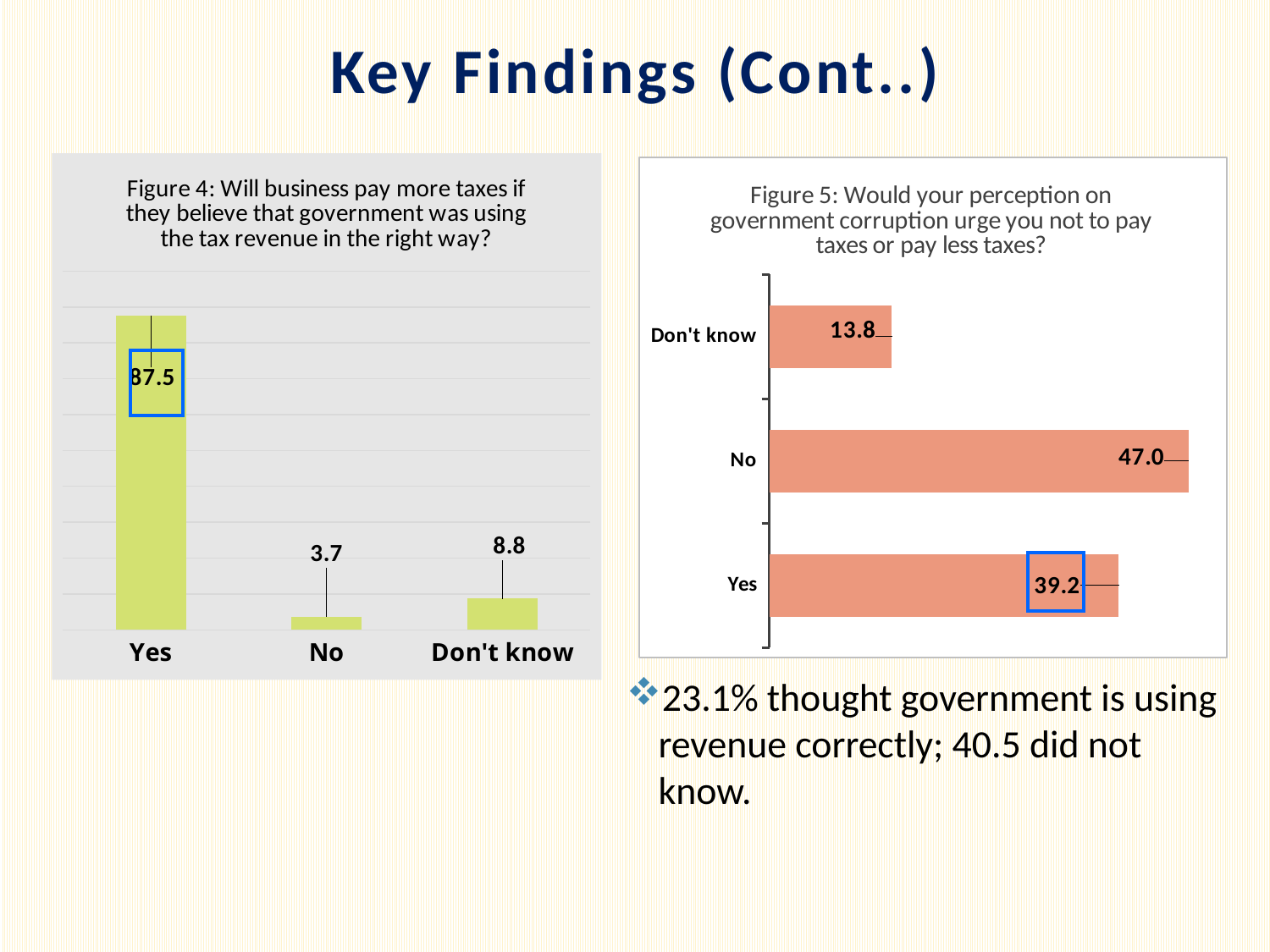
What kind of chart is Figure 5? Bar chart In Figure 5, what is the value for Don't know? 13.8 In Figure 5, what is the difference between the values for No and Yes? 7.8 In Figure 4, what is the value for Yes? 87.5 In Figure 5, what is the value for No? 47.0 In Figure 5, what is the value for Yes? 39.2 In Figure 4, what is the value for No? 3.7 In Figure 4, what is the difference between the values for Yes and Don't know? 78.7 In Figure 5, which category has the highest value? No In Figure 4, which category has the lowest value? No In Figure 5, how many categories are shown? 3 In Figure 4, what is the value for Don't know? 8.8